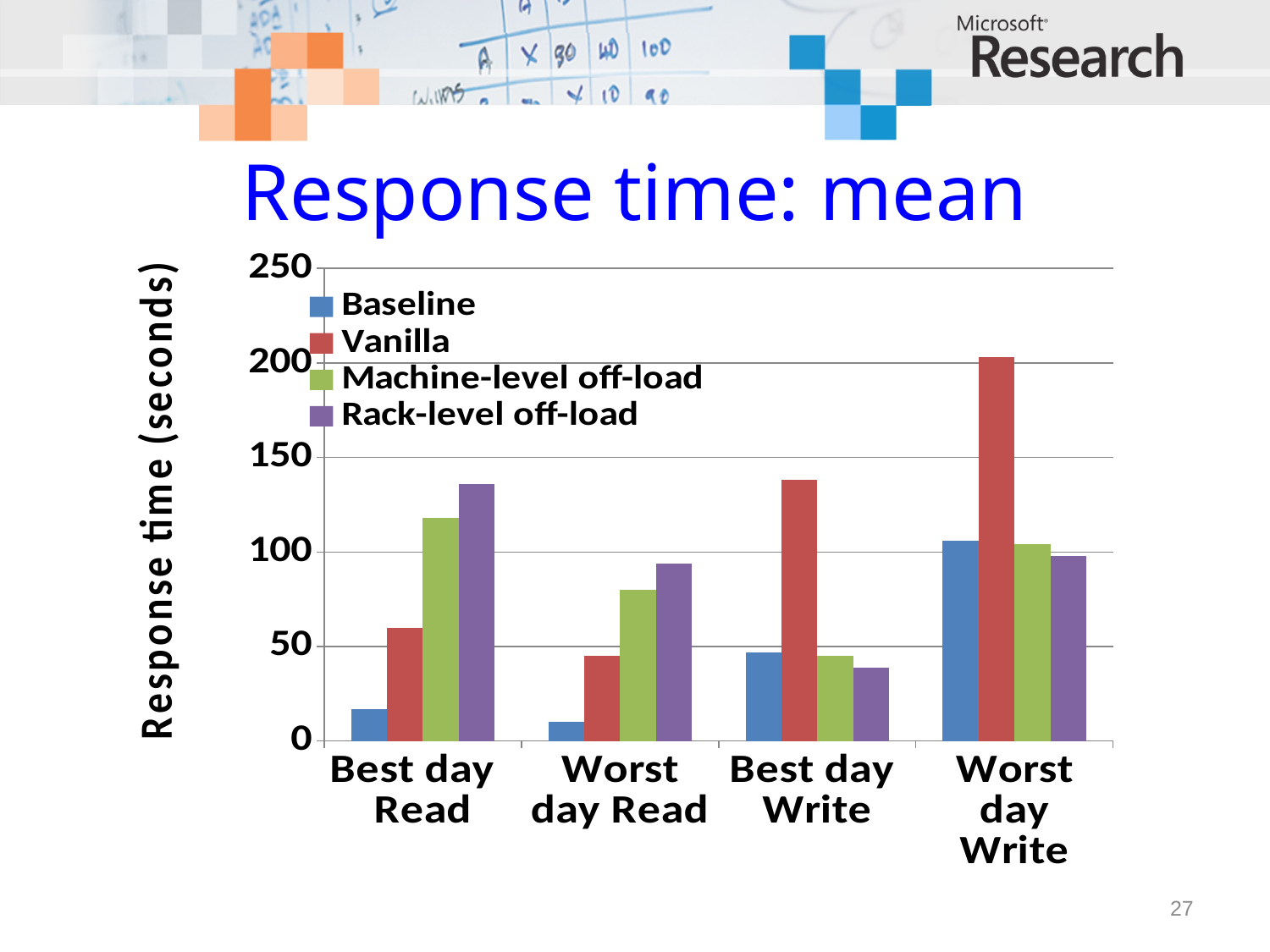
Is the Vanilla value for Worst day Write greater or less than 150? greater In the Best day Read category, which is larger: the Rack-level off-load bar or the Machine-level off-load bar? Rack-level off-load In which category is the Vanilla bar the highest? Worst day Write Which series has the highest bar in the Best day Read category? Rack-level off-load How many categories are shown on the x axis? 4 Is the Baseline value for Best day Read greater or less than 50? less Is the Rack-level off-load value for Best day Read greater or less than 100? greater What kind of chart is shown on the slide? bar chart In which category is the Baseline bar the lowest? Worst day Read What is the label on the vertical axis of the chart? Response time (seconds) How many series does the legend list? 4 In the Best day Write category, which is larger: the Vanilla bar or the Baseline bar? Vanilla